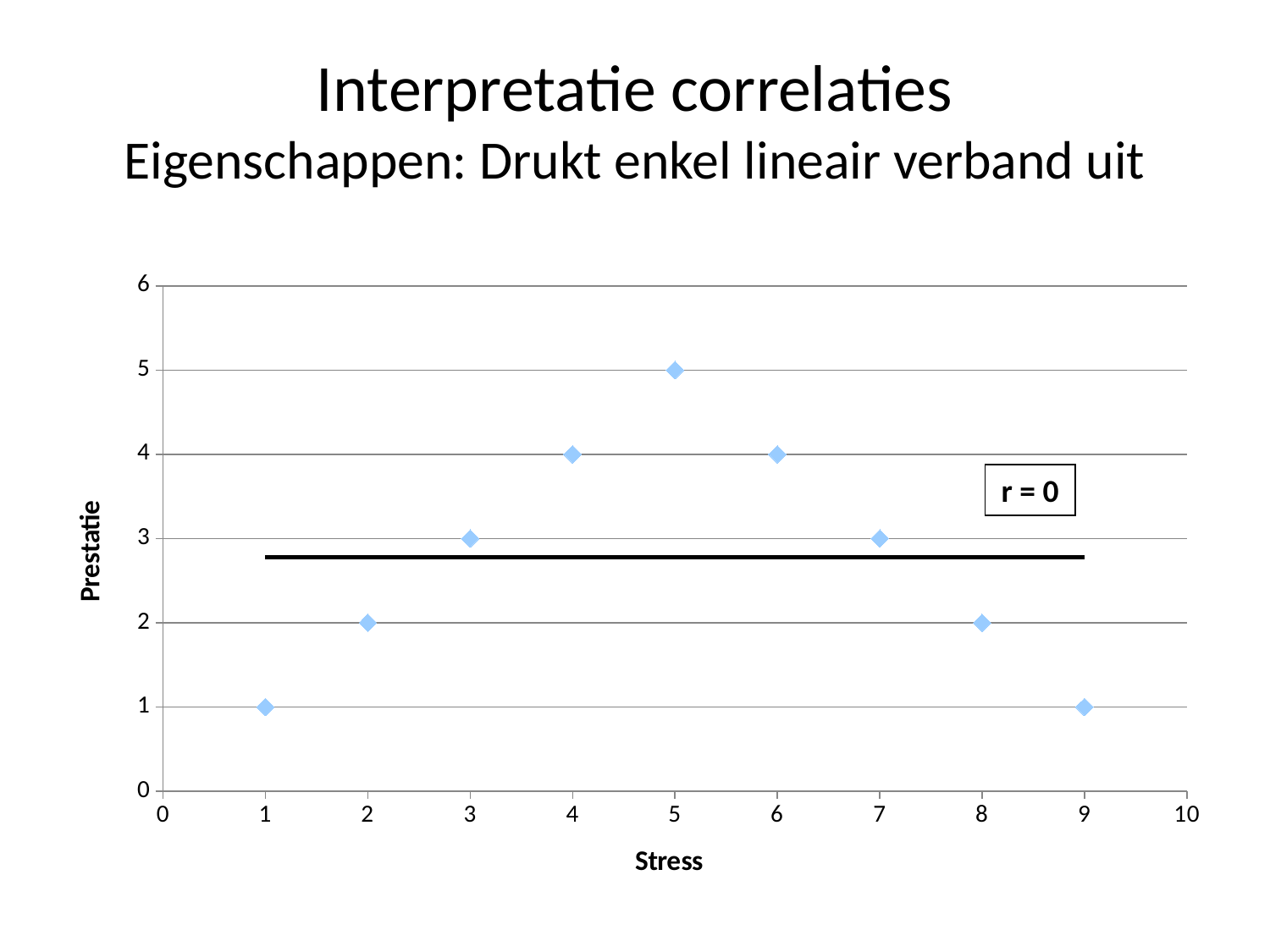
What kind of chart is shown on the slide? scatter plot What correlation value is shown in the text box on the chart? r = 0 What is the Prestatie value at Stress = 2? 2 How many data points are plotted on the chart? 9 What is the Prestatie value at Stress = 5? 5 What is the highest Prestatie value plotted? 5 What is the lowest Prestatie value plotted? 1 What is the difference between the Prestatie value at Stress = 5 and at Stress = 9? 4 How does Prestatie change as Stress increases from 1 to 9? rises until Stress = 5, then falls At which Stress value is Prestatie highest? 5 What is the Prestatie value at Stress = 8? 2 Which has a higher Prestatie value: Stress = 4 or Stress = 7? Stress = 4